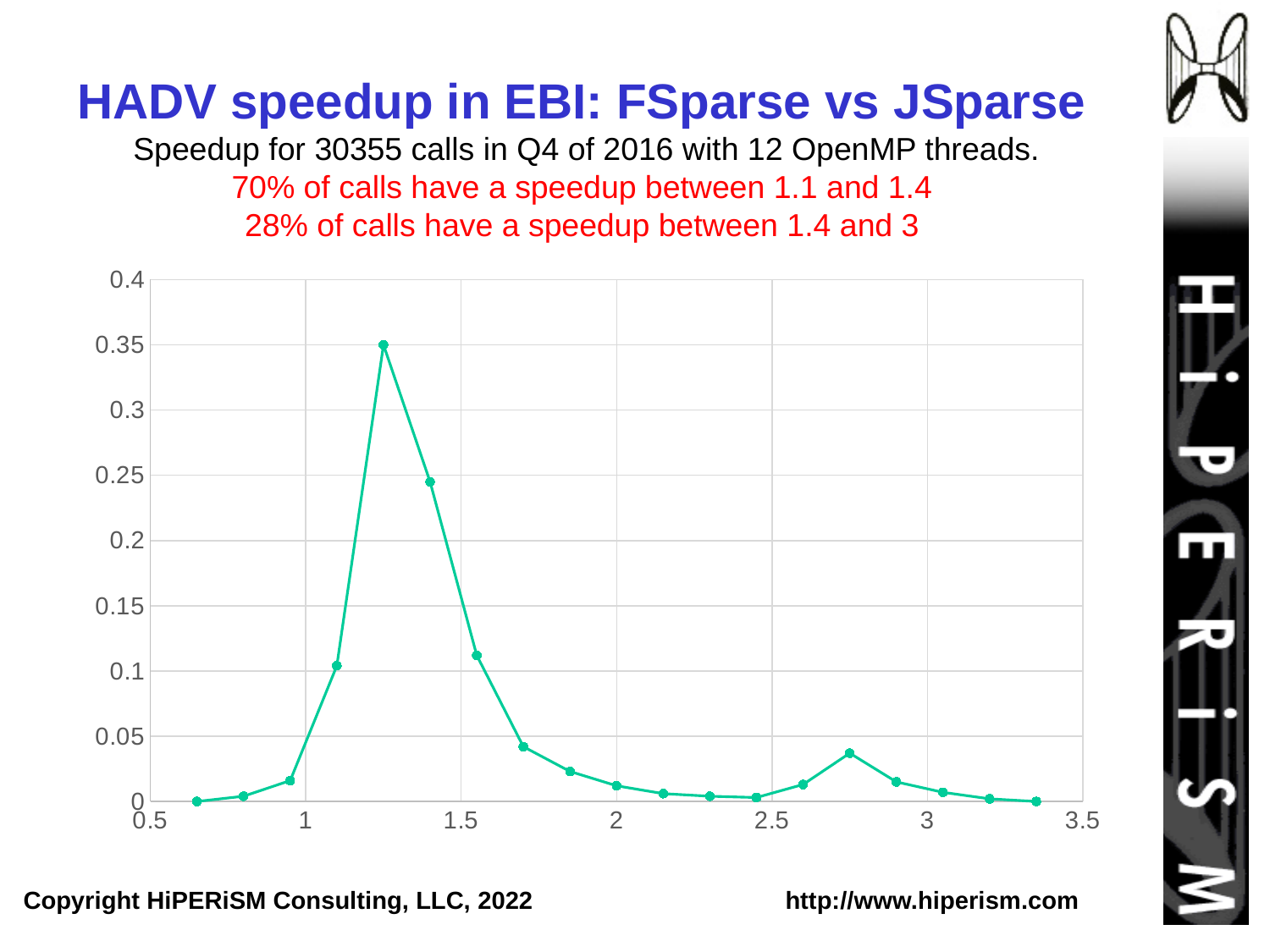
How many data points are plotted on the line? 19 What is the value at the highest point of the line, which lands on the 0.35 gridline? 0.35 Is the value at the smaller second peak (near x = 2.75) greater or less than 0.05? less What is the maximum value shown on the y axis? 0.4 What kind of chart is shown on the slide? line chart Is the value at x = 2 greater or less than 0.05? less Do the values rise or fall along the x axis from the main peak to x = 2? fall What is the title of the slide's chart? HADV speedup in EBI: FSparse vs JSparse According to the slide text, what percentage of calls have a speedup between 1.1 and 1.4? 70% Which is larger: the peak between x = 1 and x = 1.5, or the smaller peak between x = 2.5 and x = 3? the peak between 1 and 1.5 Between which two x-axis tick labels does the highest point of the line occur? 1 and 1.5 Is the value at the highest peak of the line greater or less than 0.3? greater